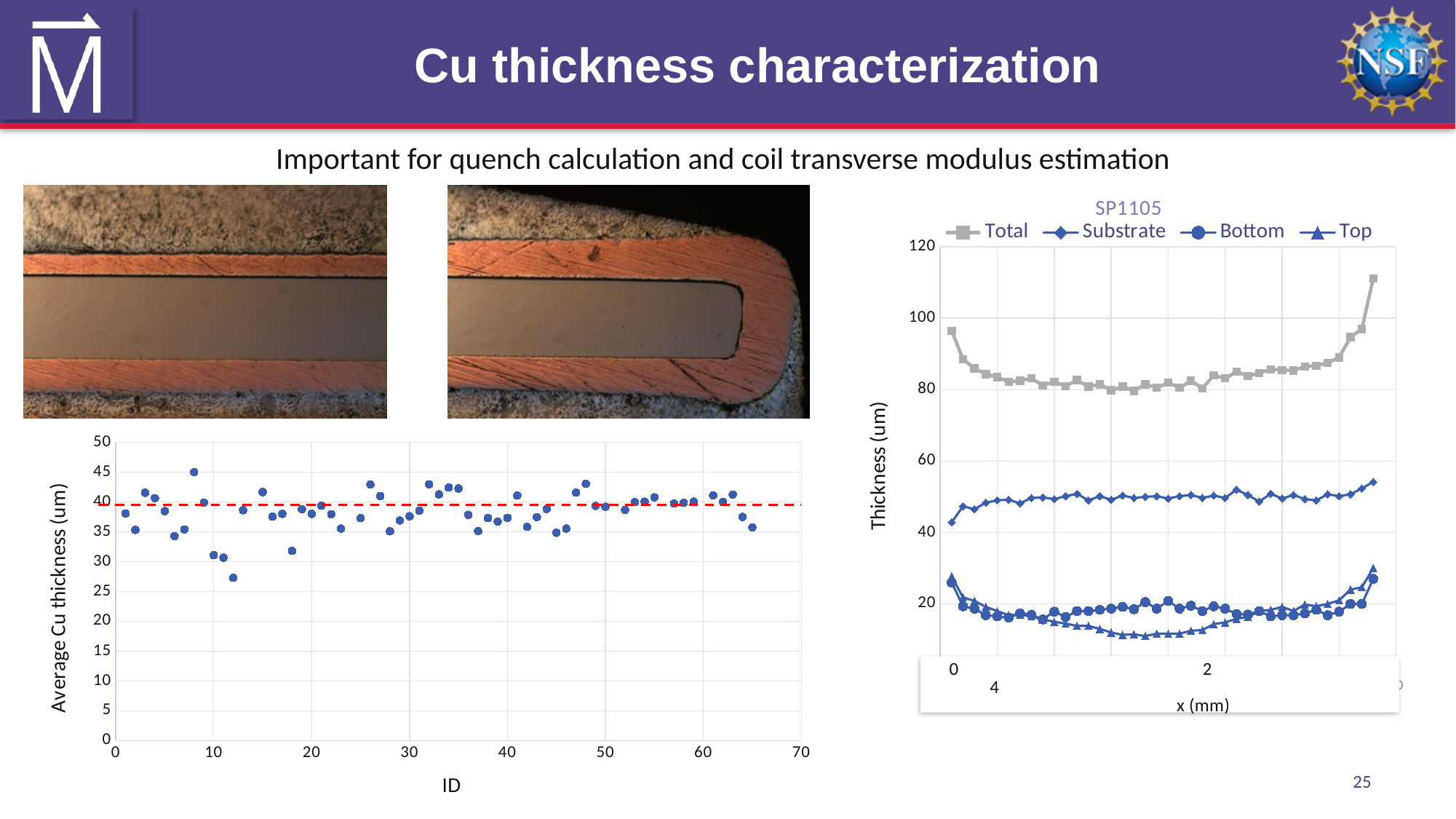
In the SP1105 chart, is the first Total value (at x = 0) greater or less than 80? greater In the SP1105 chart, which series is larger, Substrate or Bottom? Substrate In the bottom-left chart of Average Cu thickness vs ID, is the lowest point greater or less than 30? less In the SP1105 chart, is the last Total value (at the right end) greater or less than 100? greater What is the y-axis label of the SP1105 chart? Thickness (um) How many series does the legend of the SP1105 chart list? 4 What kind of chart is the chart at the bottom left of the slide, plotting Average Cu thickness against ID? scatter chart In the SP1105 chart, which series has the highest values across the whole x range? Total What kind of chart is the SP1105 chart on the right of the slide? line chart In the SP1105 chart, which series has the lowest values in the middle of the x range? Top